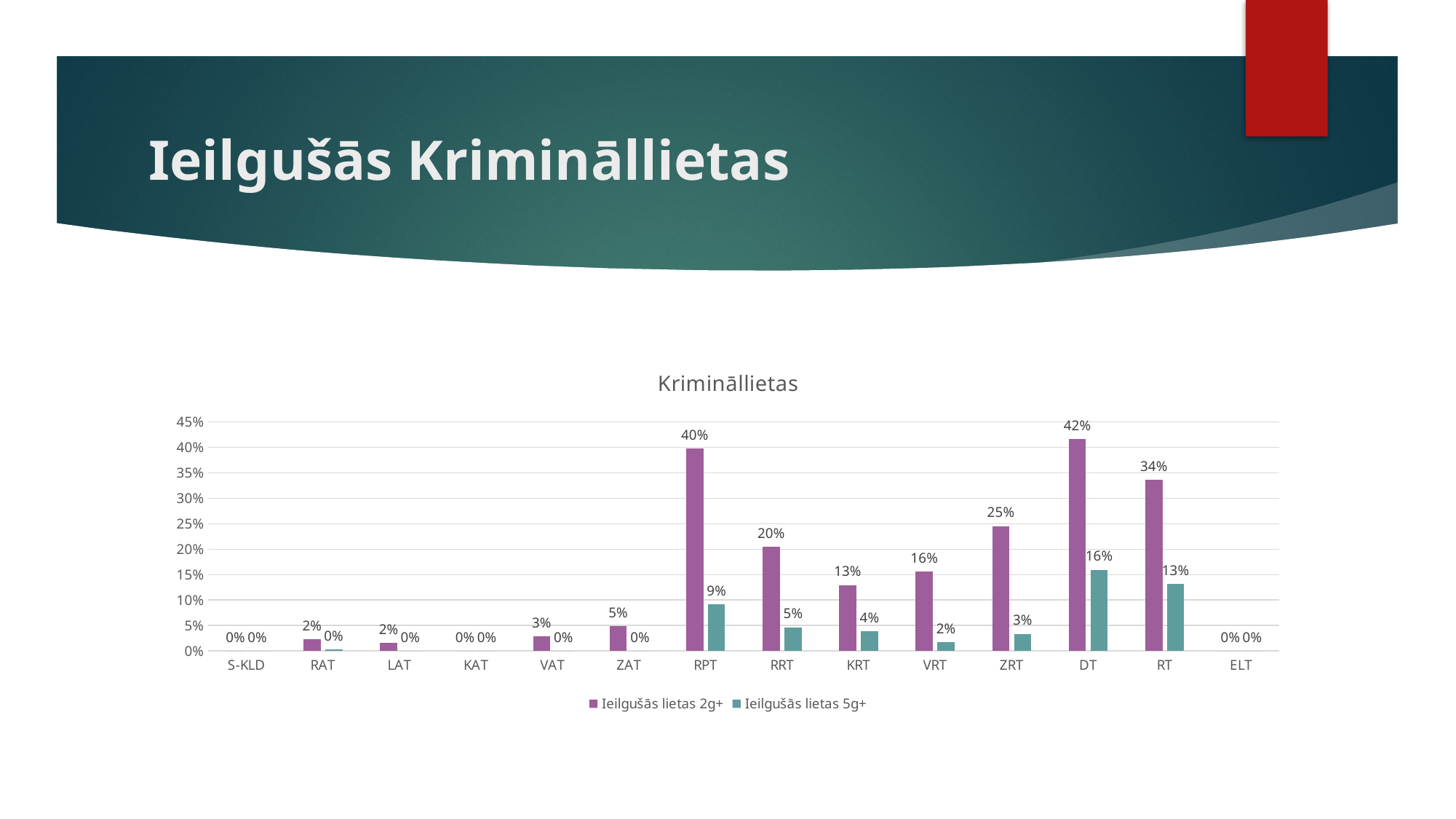
What is the difference between the Ieilgušās lietas 2g+ values for DT and RT? 8% What kind of chart is shown on the slide? Bar chart What is the difference between the Ieilgušās lietas 2g+ and Ieilgušās lietas 5g+ values for RPT? 31% Which category has the highest value in the Ieilgušās lietas 2g+ series? DT How many categories are shown on the x axis? 14 Which is larger in the Ieilgušās lietas 2g+ series: ZRT or VRT? ZRT What is the value for RRT in the Ieilgušās lietas 2g+ series? 20% What is the value for RPT in the Ieilgušās lietas 5g+ series? 9% How many series does the legend list? 2 What is the value for DT in the Ieilgušās lietas 2g+ series? 42% What is the value for RT in the Ieilgušās lietas 5g+ series? 13% Which category has the highest value in the Ieilgušās lietas 5g+ series? DT